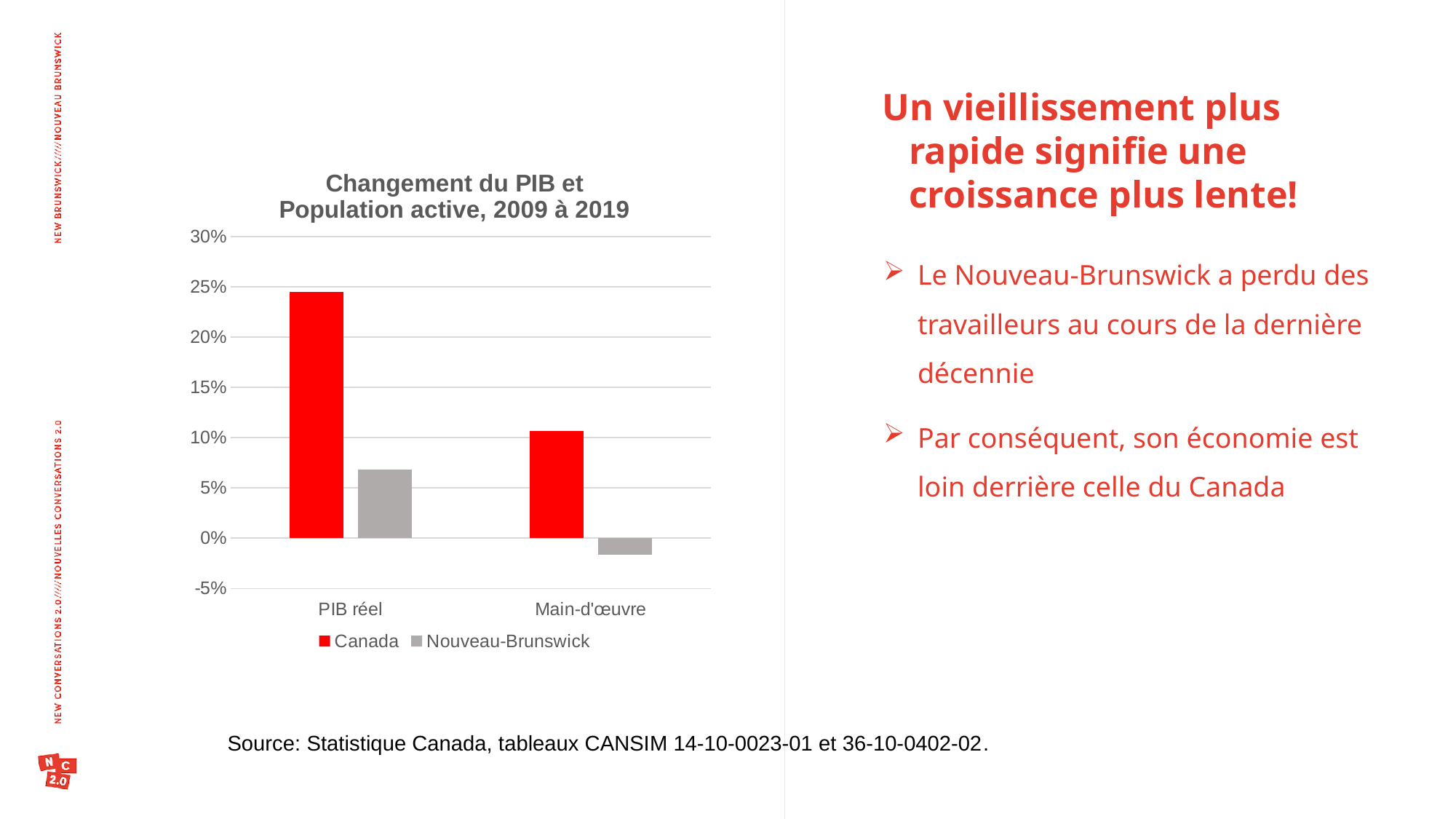
Which bar in the chart is the highest? Canada, PIB réel How many categories are shown on the x axis of the chart? 2 Which bar in the chart is the lowest? Nouveau-Brunswick, Main-d'œuvre Is the value for Nouveau-Brunswick in the Main-d'œuvre category greater or less than 0%? less Is the value for Canada in the PIB réel category greater or less than 20%? greater What kind of chart is shown on the slide? bar chart What is the title of the chart? Changement du PIB et Population active, 2009 à 2019 How many series does the chart legend list? 2 Is the value for Nouveau-Brunswick in the PIB réel category greater or less than 10%? less In the Main-d'œuvre category, which series has the larger value, Canada or Nouveau-Brunswick? Canada Which series is shown in red in the chart? Canada